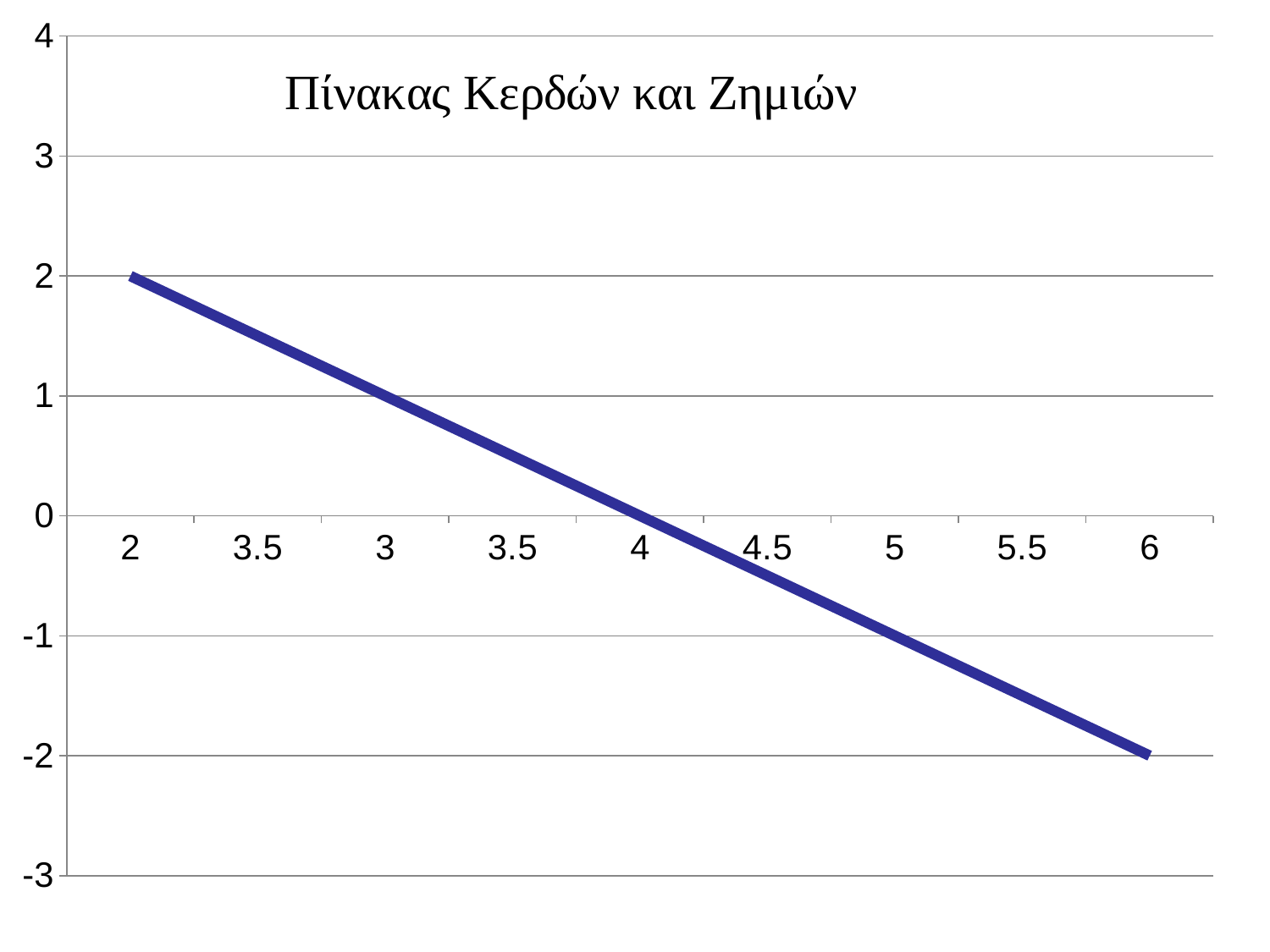
How many category labels are shown on the x axis? 9 Which has the larger value, the x-axis category 3 or the x-axis category 5? 3 What is the title of the chart? Πίνακας Κερδών και Ζημιών What is the value of the line at the x-axis category 2? 2 At which x-axis category does the line reach its lowest value? 6 What kind of chart is shown on the slide? line chart At which x-axis category does the line reach its highest value? 2 What is the value of the line at the x-axis category 4? 0 Is the value at the x-axis category 5.5 greater or less than -1? less Do the values rise or fall as you move from left to right along the x axis? fall What is the value of the line at the x-axis category 6? -2 Is the value at the x-axis category 4.5 greater or less than 0? less